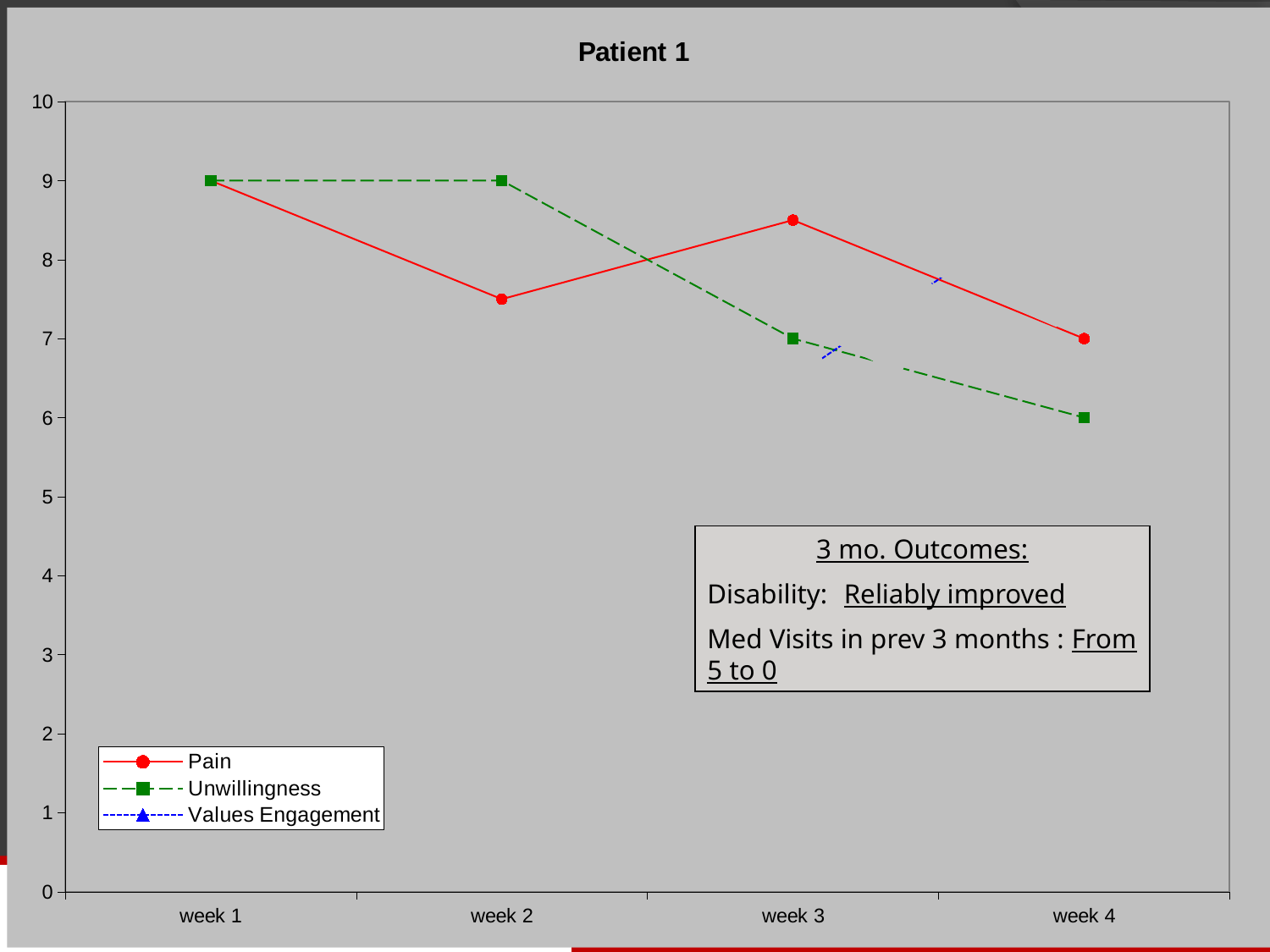
How many series does the legend list? 3 Does the Unwillingness series rise or fall from week 1 to week 4? fall By how much does Unwillingness decrease from week 1 to week 4? 3 What is the Unwillingness value at week 4? 6 What is the Pain value at week 4? 7 What is the Unwillingness value at week 1? 9 How many weeks are shown on the x axis? 4 Is the Pain value at week 3 greater or less than 8? greater At week 3, which is larger, Pain or Unwillingness? Pain Is the Pain value at week 2 greater or less than 8? less What is the title of the chart? Patient 1 What kind of chart is shown on the slide? line chart